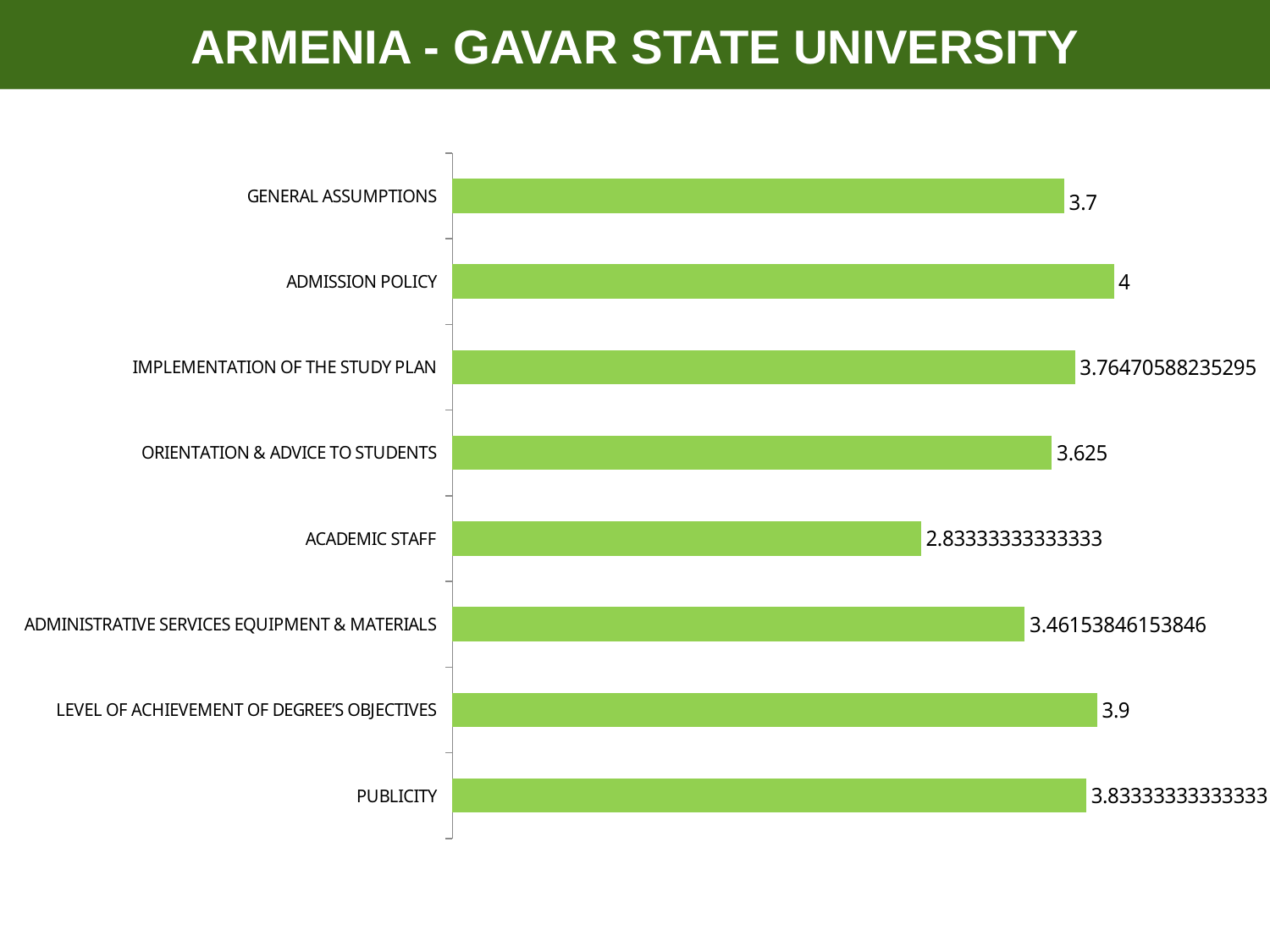
How many categories are shown in the chart? 8 What is the value for ADMISSION POLICY? 4 Which category has the lowest value? ACADEMIC STAFF What is the difference between the values for ADMISSION POLICY and GENERAL ASSUMPTIONS? 0.3 What is the title of the slide? ARMENIA - GAVAR STATE UNIVERSITY What kind of chart is shown on the slide? Bar chart What is the value for ADMINISTRATIVE SERVICES EQUIPMENT & MATERIALS? 3.46153846153846 What is the value for ORIENTATION & ADVICE TO STUDENTS? 3.625 Which is larger, the value for PUBLICITY or the value for GENERAL ASSUMPTIONS? PUBLICITY Which category has the highest value? ADMISSION POLICY What is the difference between the values for LEVEL OF ACHIEVEMENT OF DEGREE'S OBJECTIVES and ORIENTATION & ADVICE TO STUDENTS? 0.275 What is the value for ACADEMIC STAFF? 2.83333333333333